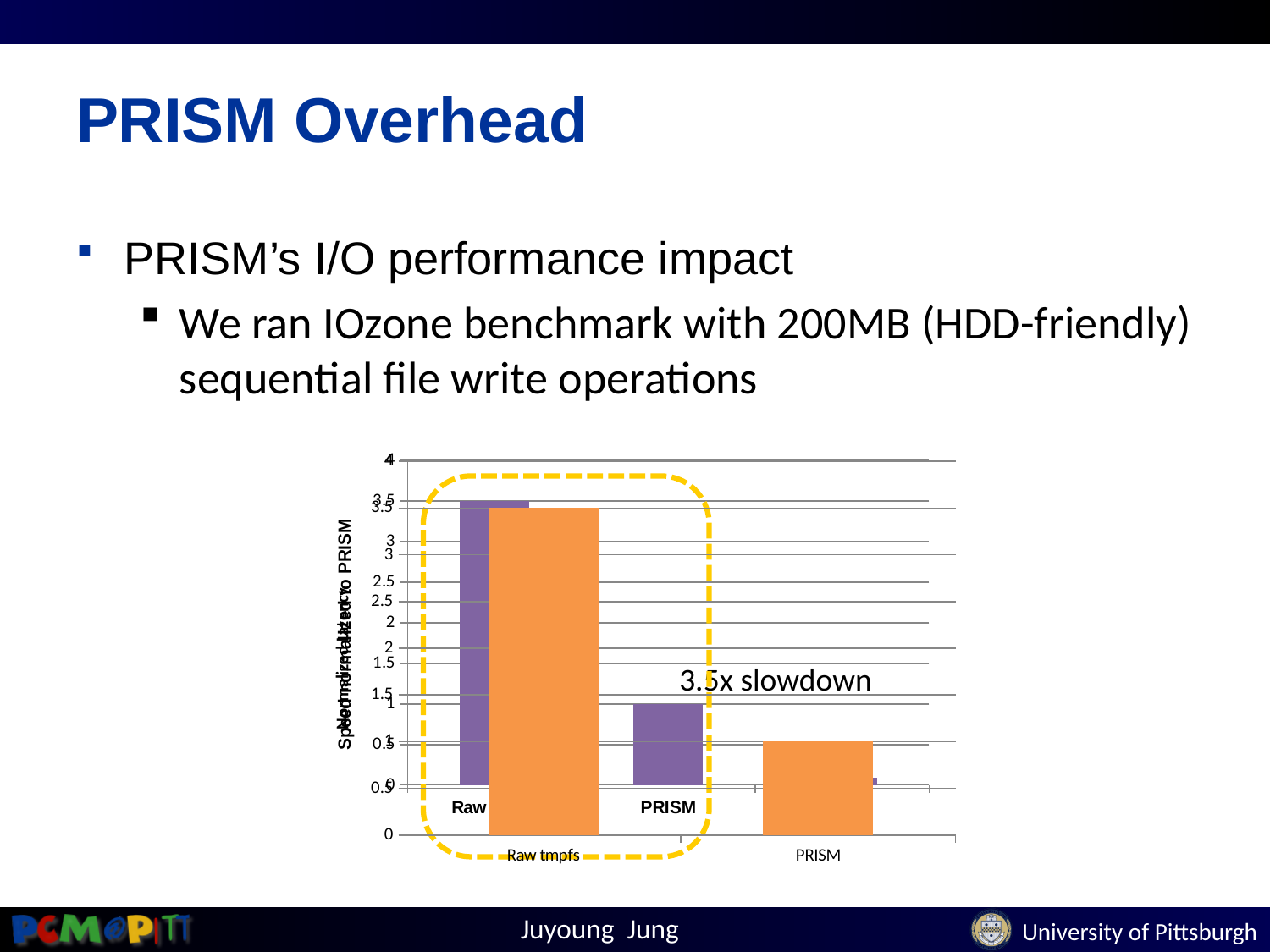
In the purple bar chart, which category has the highest bar? Raw In the orange bar chart, which is larger, the bar for Raw tmpfs or the bar for PRISM? Raw tmpfs In the orange bar chart, is the bar for Raw tmpfs greater or less than 3? greater In the orange bar chart, is the bar for PRISM greater or less than 2? less What kind of chart is shown on the slide? bar chart What slowdown factor is annotated on the chart? 3.5x slowdown In the orange bar chart, how many categories are shown on the x axis? 2 In the orange bar chart, which category has the highest bar? Raw tmpfs In the orange bar chart, which category has the lowest bar? PRISM What is the highest value shown on the y axis of the chart? 4 In the purple bar chart, is the bar for PRISM greater or less than 2? less